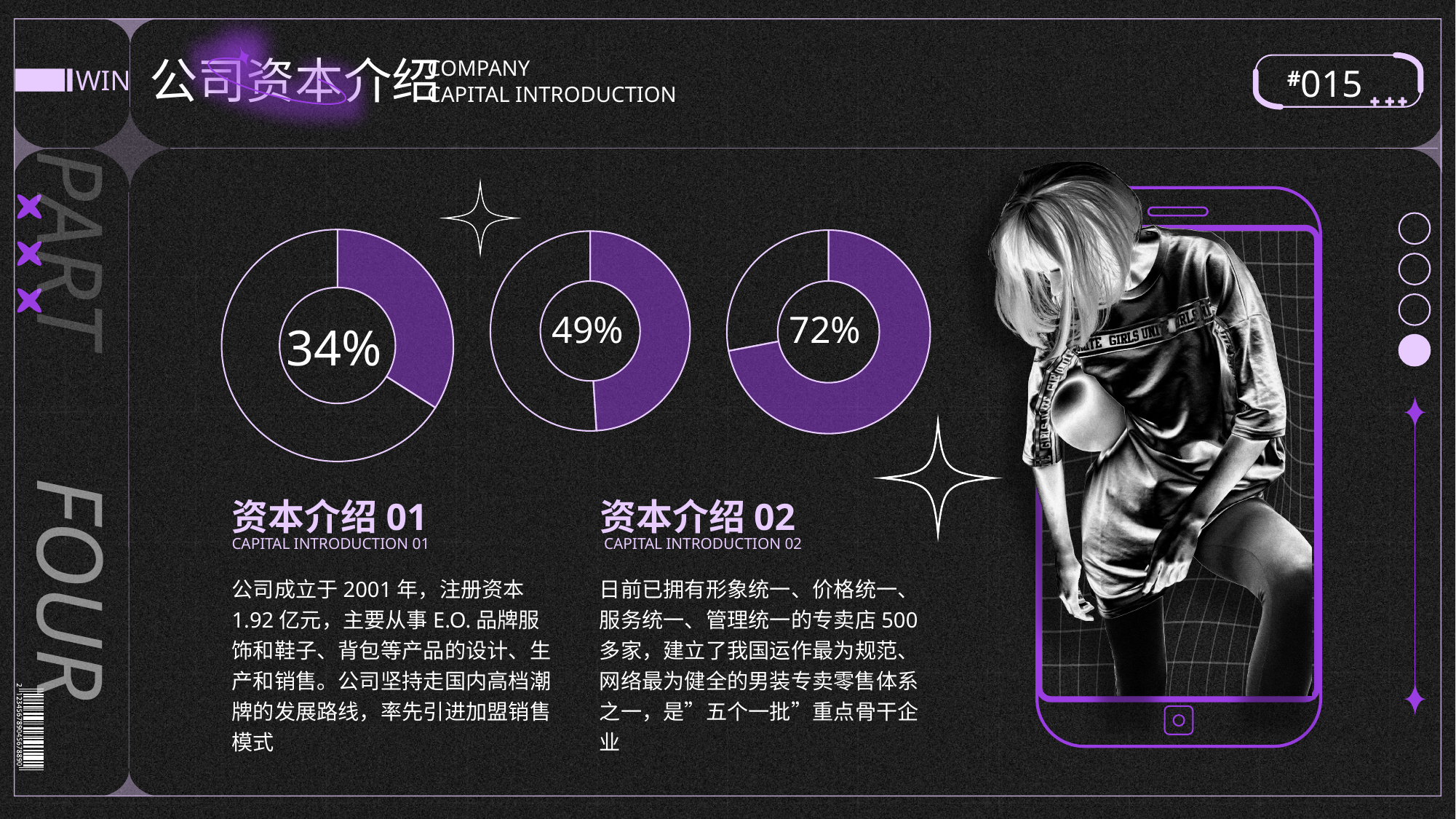
Which of the three donut charts shows the lowest percentage? The left one (34%) What percentage is shown in the centre of the right donut chart? 72% What percentage is shown in the centre of the middle donut chart? 49% What colour is the filled portion of each donut chart? Purple Which of the three donut charts shows the highest percentage? The right one (72%) Is the percentage in the middle donut chart greater or less than 50%? less What is the difference between the percentage in the right donut chart and the percentage in the left donut chart? 38% What percentage is shown in the centre of the left donut chart? 34% What kind of chart is used to display the three percentages on the slide? Donut chart Which is larger, the percentage in the middle donut chart or the percentage in the right donut chart? The right donut chart (72%) How many donut charts are shown on the slide? 3 What is the difference between the percentage in the middle donut chart and the percentage in the left donut chart? 15%